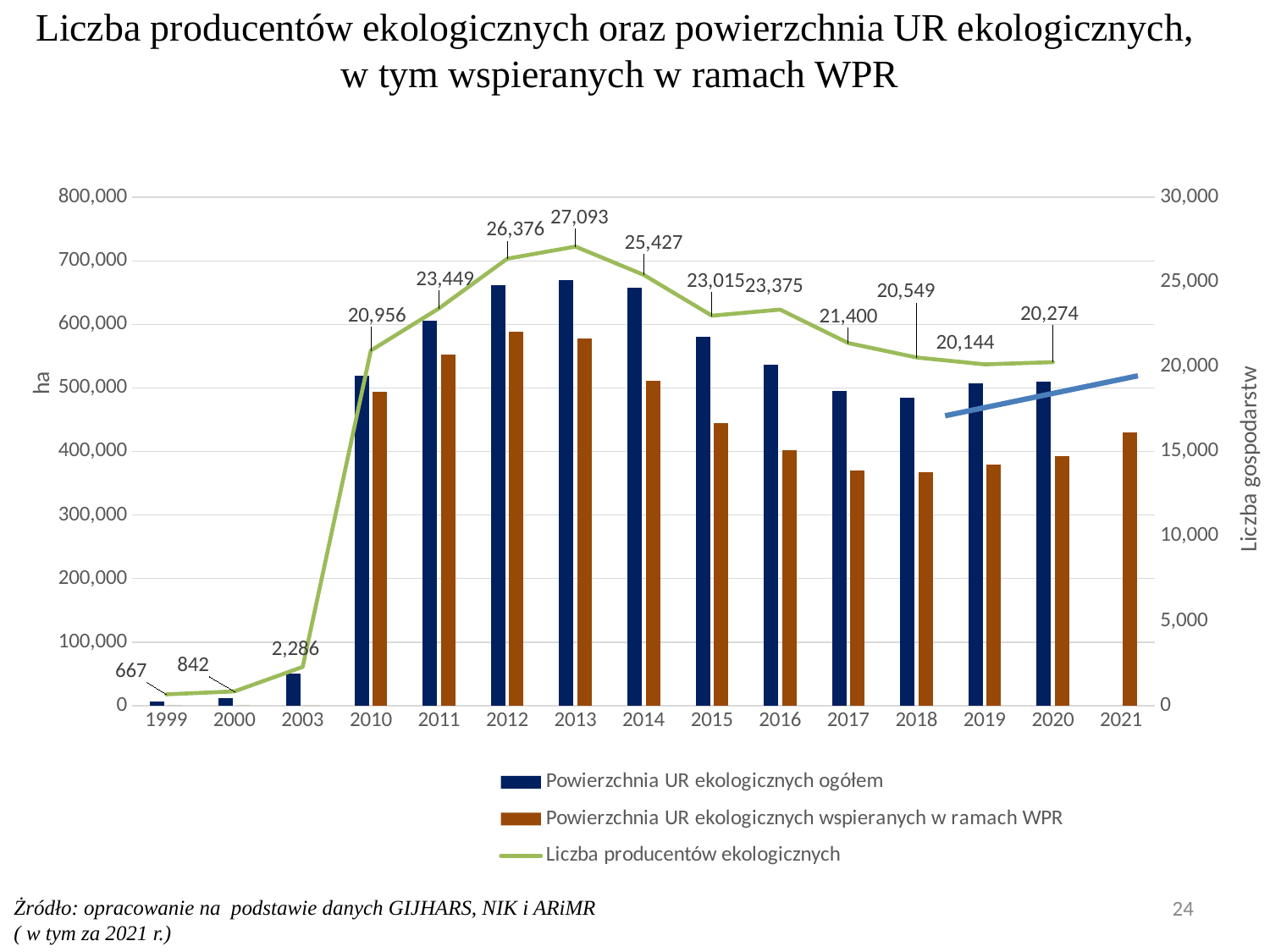
Does Liczba producentów ekologicznych rise or fall from 2013 to 2019? fall How many series does the legend list? 3 Is the value of Powierzchnia UR ekologicznych wspieranych w ramach WPR in 2017 greater or less than 400,000? less What is the difference in Liczba producentów ekologicznych between 2013 and 2012? 717 In which year is Liczba producentów ekologicznych the lowest? 1999 How many years are shown on the x axis of the chart? 15 Which year has a larger Liczba producentów ekologicznych, 2015 or 2016? 2016 What is the value of Liczba producentów ekologicznych in 2010? 20,956 Is the value of Powierzchnia UR ekologicznych ogółem in 2013 greater or less than 600,000? greater What kind of chart is shown on the slide? Combination bar and line chart What is the value of Liczba producentów ekologicznych in 2013? 27,093 In which year is Liczba producentów ekologicznych the highest? 2013